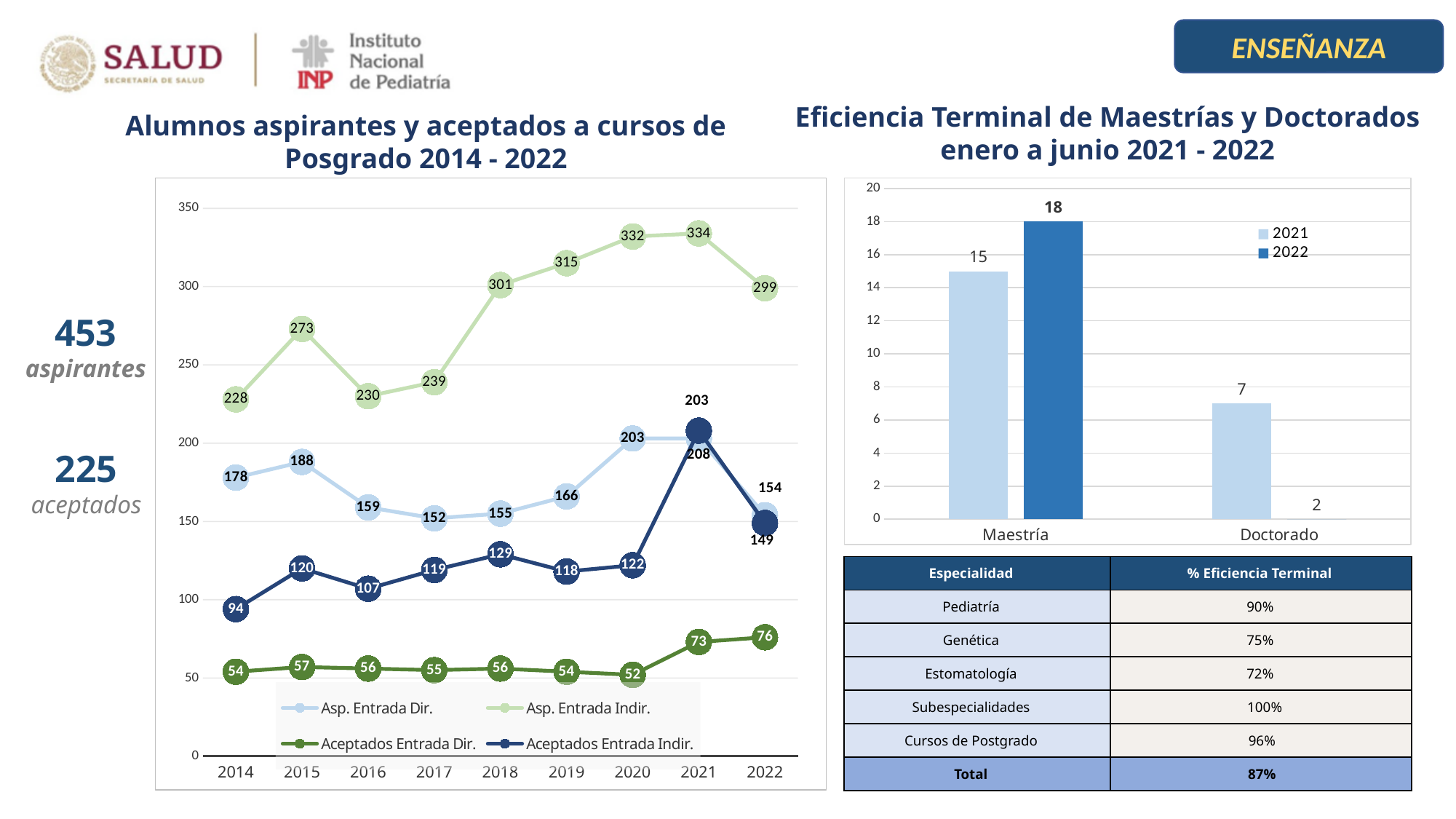
In the chart 'Eficiencia Terminal de Maestrías y Doctorados enero a junio 2021 - 2022', what is the difference between Maestría 2022 and Maestría 2021? 3 In the chart 'Alumnos aspirantes y aceptados a cursos de Posgrado 2014 - 2022', how many years are shown on the x axis? 9 In the chart 'Alumnos aspirantes y aceptados a cursos de Posgrado 2014 - 2022', what is the value of Asp. Entrada Indir. in 2021? 334 In the chart 'Alumnos aspirantes y aceptados a cursos de Posgrado 2014 - 2022', what is the value of Aceptados Entrada Dir. in 2022? 76 In the chart 'Eficiencia Terminal de Maestrías y Doctorados enero a junio 2021 - 2022', which is larger for Doctorado: 2021 or 2022? 2021 What kind of chart is 'Eficiencia Terminal de Maestrías y Doctorados enero a junio 2021 - 2022'? bar chart In the chart 'Eficiencia Terminal de Maestrías y Doctorados enero a junio 2021 - 2022', what is the value for Maestría in 2022? 18 In the chart 'Alumnos aspirantes y aceptados a cursos de Posgrado 2014 - 2022', in which year is Asp. Entrada Indir. highest? 2021 In the chart 'Alumnos aspirantes y aceptados a cursos de Posgrado 2014 - 2022', what is the difference between Asp. Entrada Indir. and Asp. Entrada Dir. in 2014? 50 In the chart 'Alumnos aspirantes y aceptados a cursos de Posgrado 2014 - 2022', how many series does the legend list? 4 In the chart 'Alumnos aspirantes y aceptados a cursos de Posgrado 2014 - 2022', what is the value of Aceptados Entrada Indir. in 2014? 94 In the chart 'Alumnos aspirantes y aceptados a cursos de Posgrado 2014 - 2022', in which year is Aceptados Entrada Dir. lowest? 2020